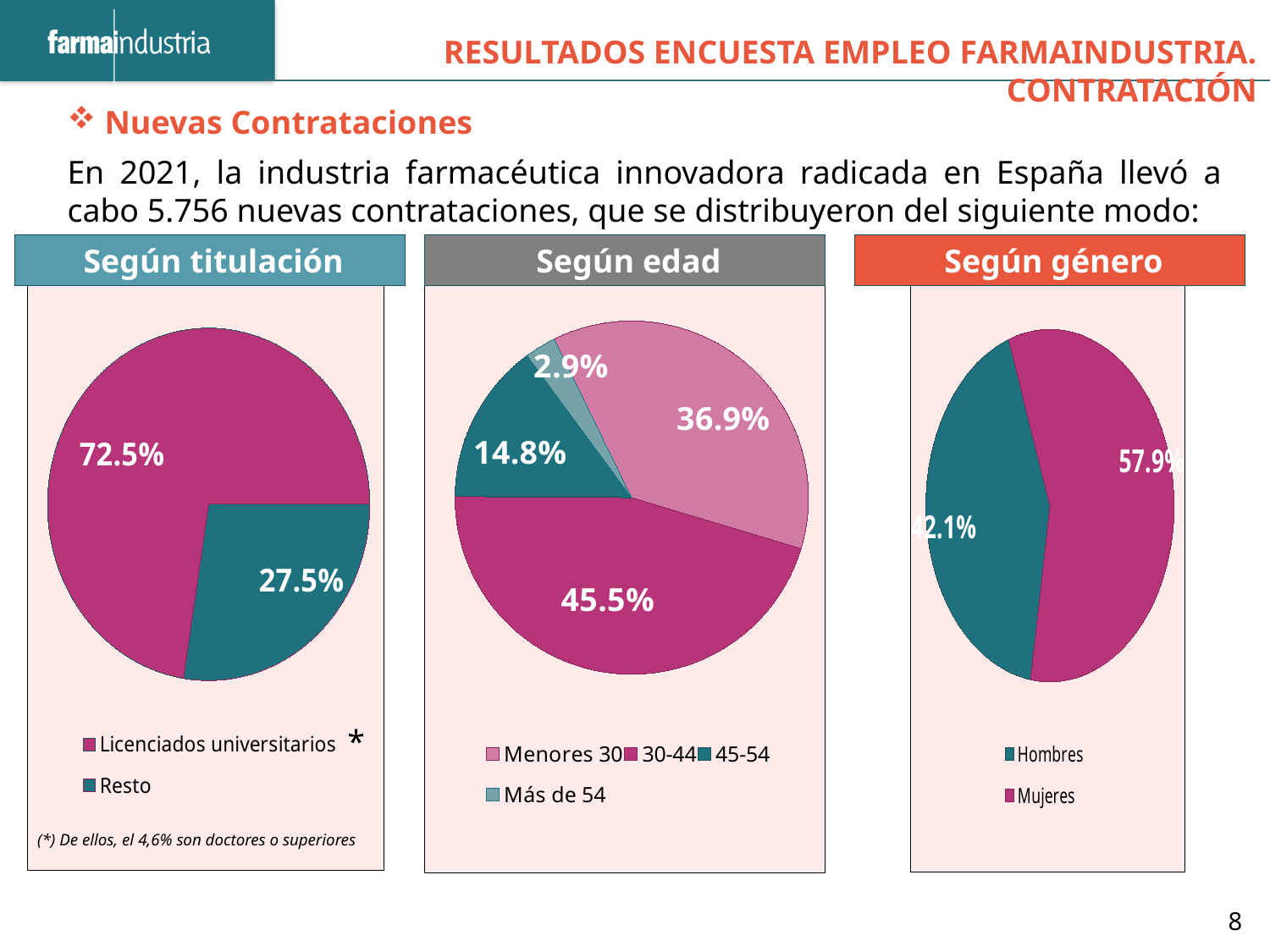
In the 'Según edad' chart, how many categories does the legend list? 4 In the 'Según titulación' chart, what share is labelled for Resto? 27.5% In the 'Según género' chart, what is the difference in percentage points between Mujeres and Hombres? 15.8 In the 'Según edad' chart, what share is labelled for Menores 30? 36.9% In the 'Según titulación' chart, what share is labelled for Licenciados universitarios? 72.5% In the 'Según género' chart, what share is labelled for Mujeres? 57.9% In the 'Según edad' chart, what share is labelled for Más de 54? 2.9% In the 'Según edad' chart, what share is labelled for the 30-44 age group? 45.5% In the 'Según titulación' chart, which is larger, Licenciados universitarios or Resto? Licenciados universitarios In the 'Según edad' chart, which age group has the smallest share? Más de 54 In the 'Según edad' chart, which age group has the largest share? 30-44 What type of chart is used in the 'Según género' panel? Pie chart